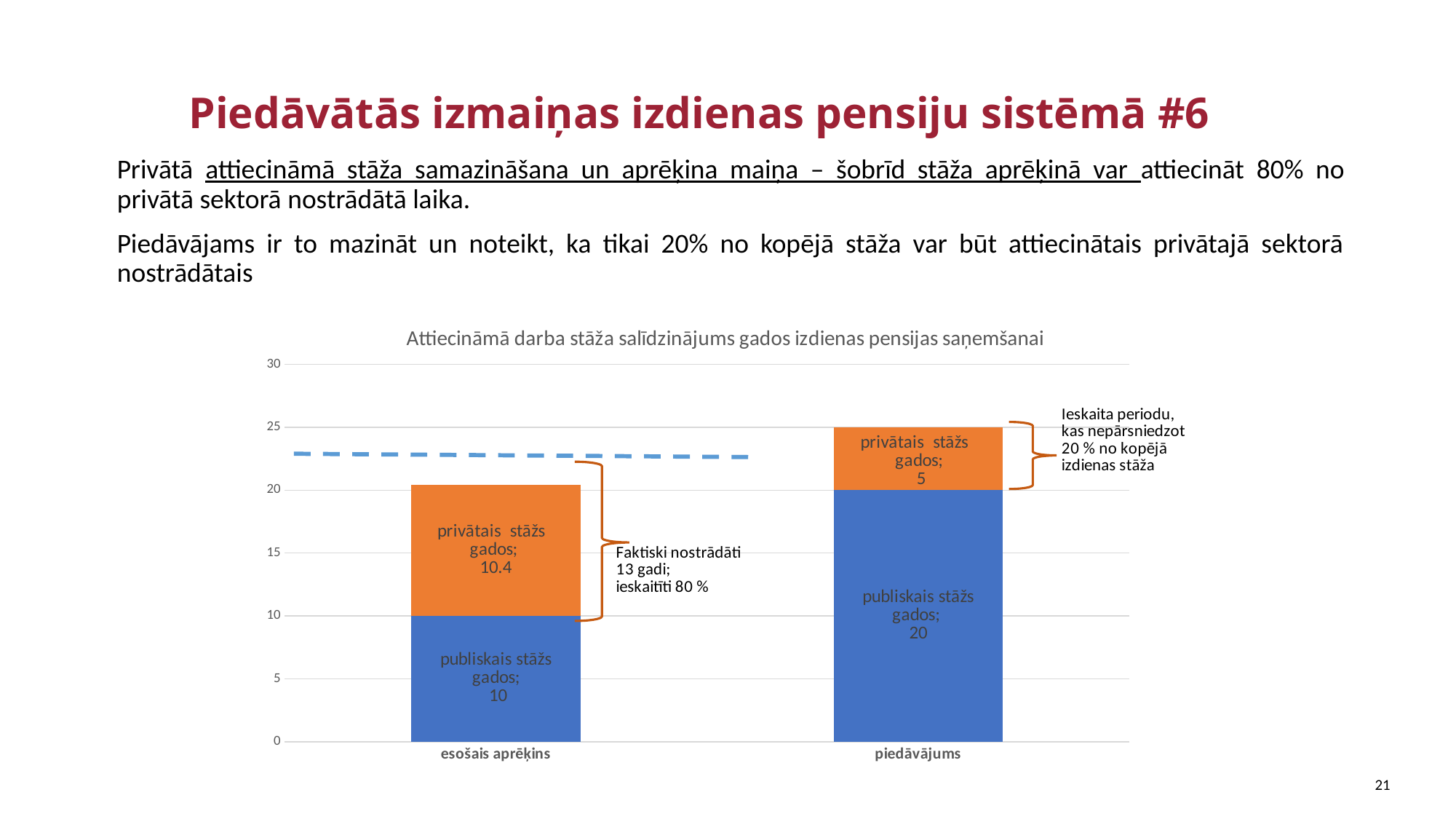
How many categories are shown on the x axis? 2 What is the value of 'publiskais stāžs gados' for 'esošais aprēķins'? 10 What is the total height of the stacked bar for 'esošais aprēķins'? 20.4 What is the difference between the 'publiskais stāžs gados' values for 'piedāvājums' and 'esošais aprēķins'? 10 What is the title of the chart? Attiecināmā darba stāža salīdzinājums gados izdienas pensijas saņemšanai Which category has the higher total stacked bar? piedāvājums Which category has the larger 'privātais stāžs gados' value, 'esošais aprēķins' or 'piedāvājums'? esošais aprēķins What is the value of 'publiskais stāžs gados' for 'piedāvājums'? 20 What kind of chart is shown on the slide? Stacked bar chart What is the total height of the stacked bar for 'piedāvājums'? 25 What is the value of 'privātais stāžs gados' for 'piedāvājums'? 5 What is the value of 'privātais stāžs gados' for 'esošais aprēķins'? 10.4